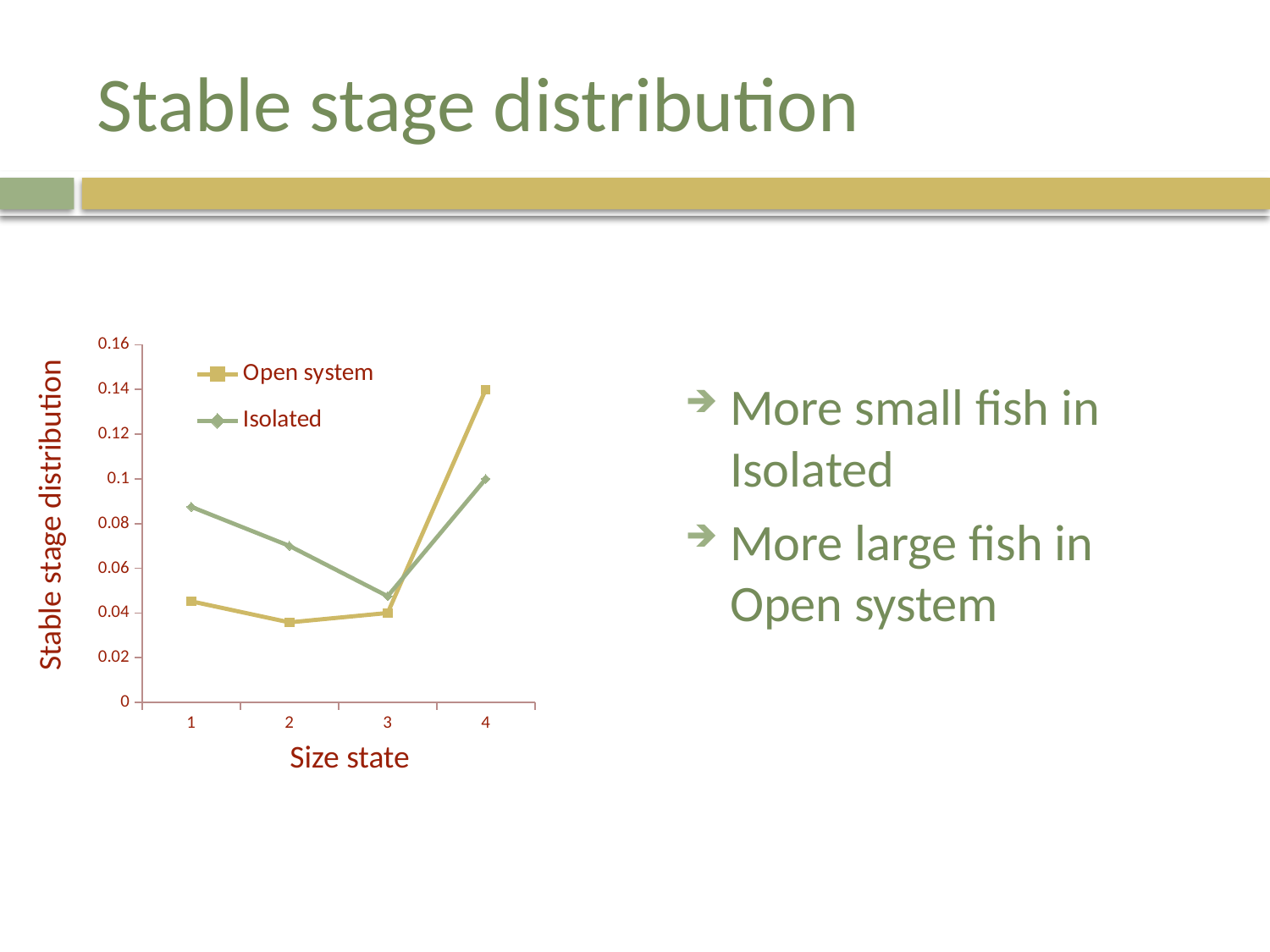
Is the value for Open system at size state 2 greater or less than 0.04? less At which size state does the Isolated series reach its lowest value? 3 At which size state does the Isolated series reach its highest value? 4 How many series does the legend list? 2 Is the value for Isolated at size state 1 greater or less than 0.08? greater What is the title of the x axis? Size state At size state 1, which series has the larger value, Open system or Isolated? Isolated At which size state does the Open system series reach its highest value? 4 At size state 4, which series has the larger value, Open system or Isolated? Open system What kind of chart is shown on the slide? line chart At which size state does the Open system series reach its lowest value? 2 How many size states are plotted along the x axis? 4